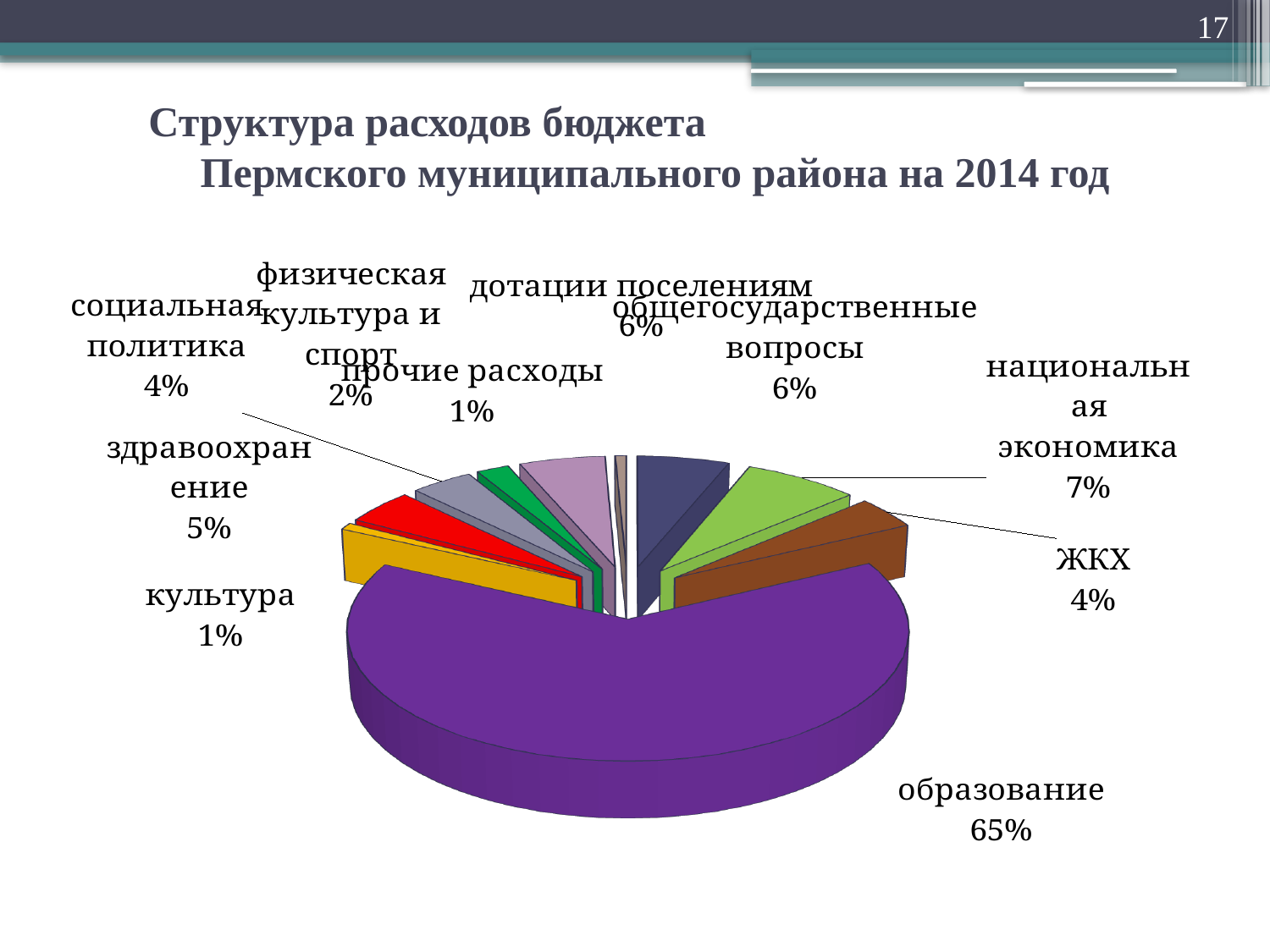
What is the difference between the shares of здравоохранение and социальная политика? 1% Which is larger, the share of общегосударственные вопросы or the share of ЖКХ? общегосударственные вопросы What share of the budget expenditure goes to образование? 65% What is the value for национальная экономика? 7% What is the difference between the shares of образование and национальная экономика? 58% What is the value for физическая культура и спорт? 2% What is the value for ЖКХ? 4% What kind of chart is shown on the slide? pie chart What year does the chart title refer to? 2014 Which category has the largest share of the pie? образование How many categories are shown in the pie chart? 10 What is the value for здравоохранение? 5%